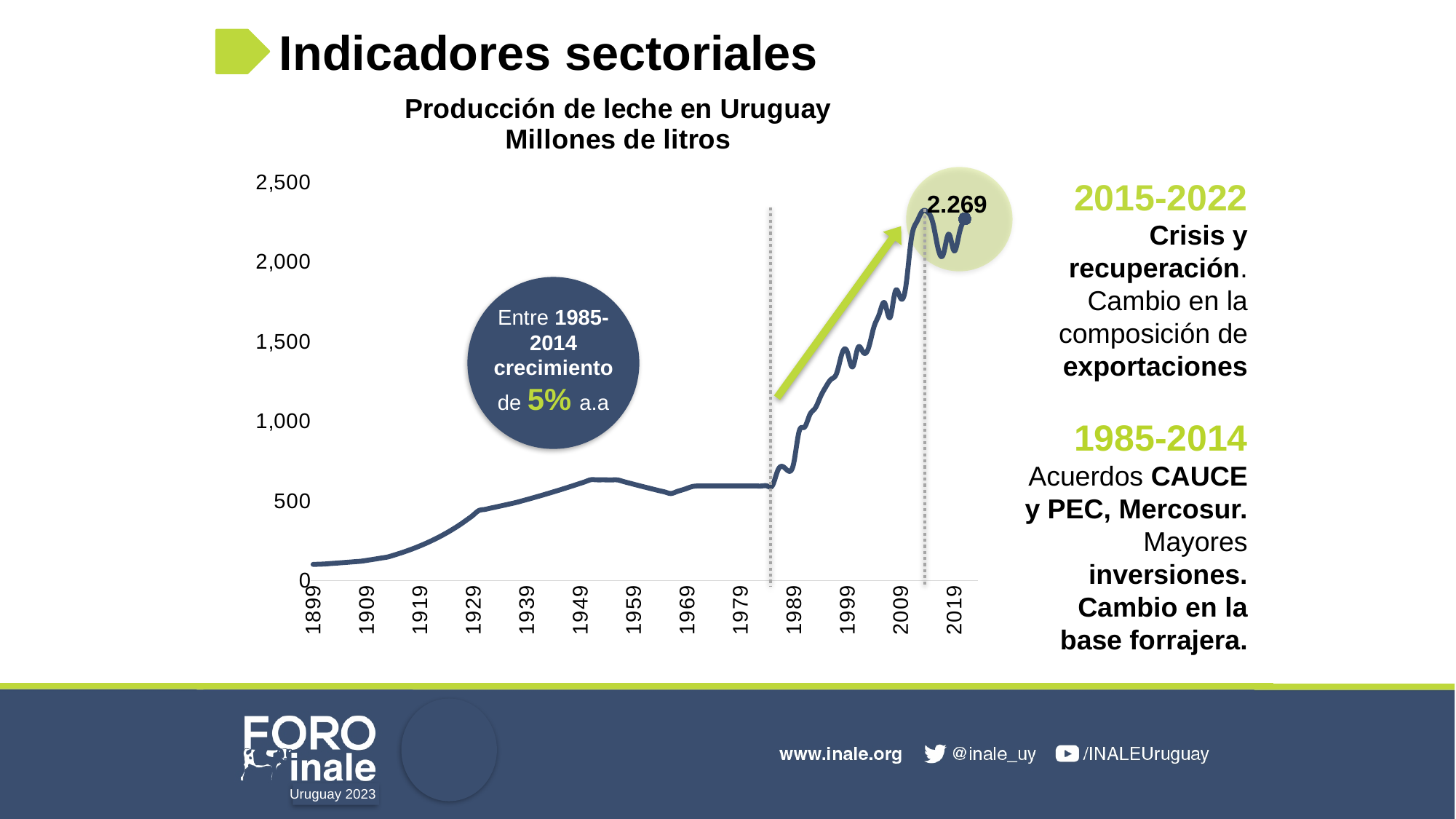
Is the value for 1919 greater or less than 500? less What value is printed as the data label at the end of the line? 2.269 Which year has the larger value, 1999 or 2009? 2009 What is the title of the chart? Producción de leche en Uruguay Millones de litros According to the annotation on the chart, what was the annual growth rate between 1985 and 2014? 5% What kind of chart is shown on the slide? line chart Is the value for 2009 greater or less than 1,500? greater Which year has the larger value, 1899 or 2019? 2019 Overall, does milk production rise or fall from 1899 to 2019? rise Is the value for 1899 greater or less than 500? less